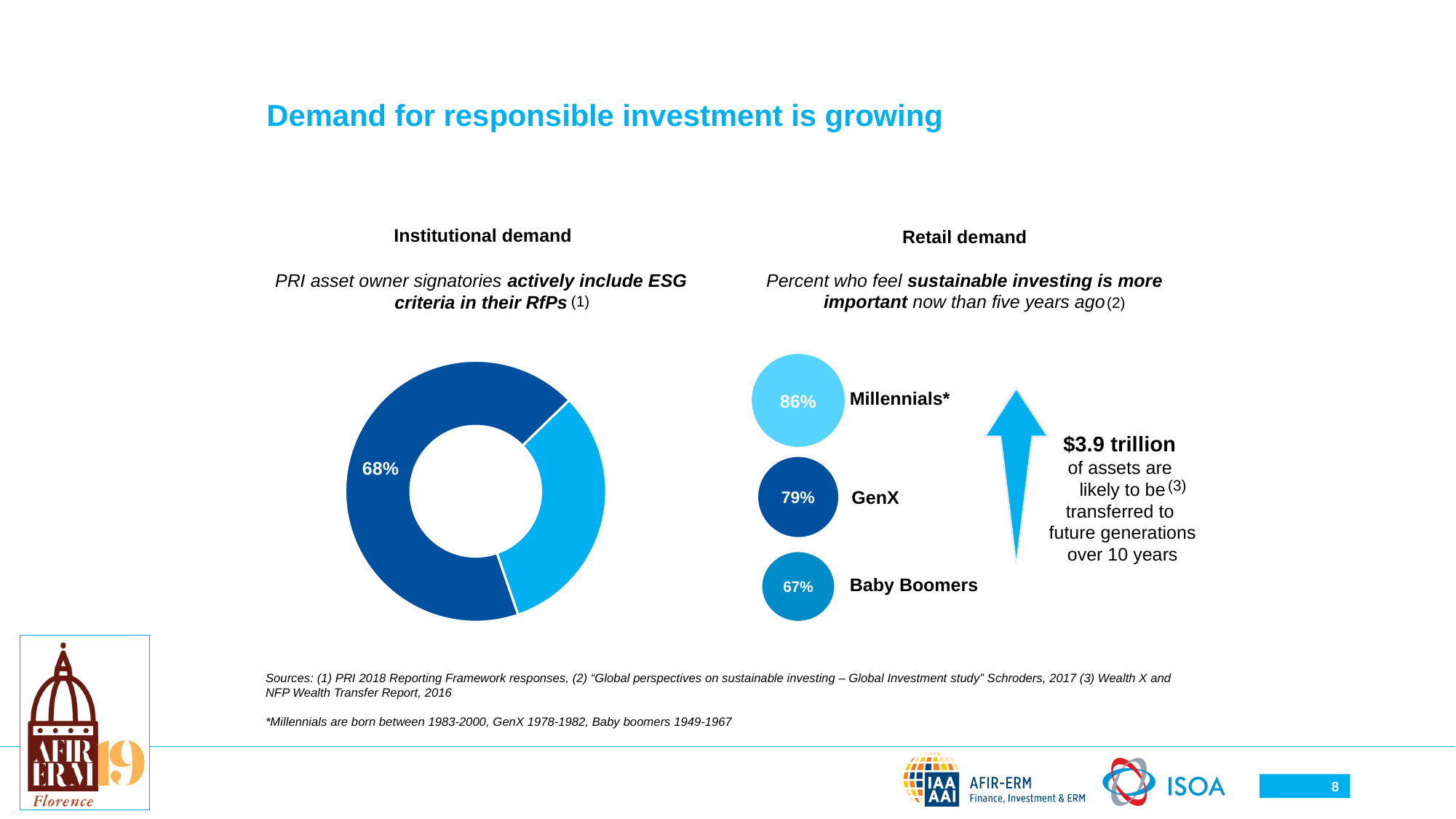
On the Institutional demand donut chart, is the dark blue slice or the light blue slice larger? Dark blue How many slices does the Institutional demand donut chart have? 2 How many generations are shown on the Retail demand chart? 3 On the Retail demand chart, what is the value for Baby Boomers? 67% On the Retail demand chart, what is the value for GenX? 79% On the Retail demand chart, what percent of Millennials feel sustainable investing is more important now than five years ago? 86% On the Institutional demand donut chart, is the labelled slice greater or less than 50%? greater What kind of chart is shown under Institutional demand? Donut (pie) chart On the Retail demand chart, what is the difference between the Millennials and Baby Boomers values? 19% On the Retail demand chart, which generation has the lowest percentage? Baby Boomers On the Retail demand chart, which generation has the highest percentage? Millennials On the Institutional demand chart, what percentage of PRI asset owner signatories actively include ESG criteria in their RfPs? 68%